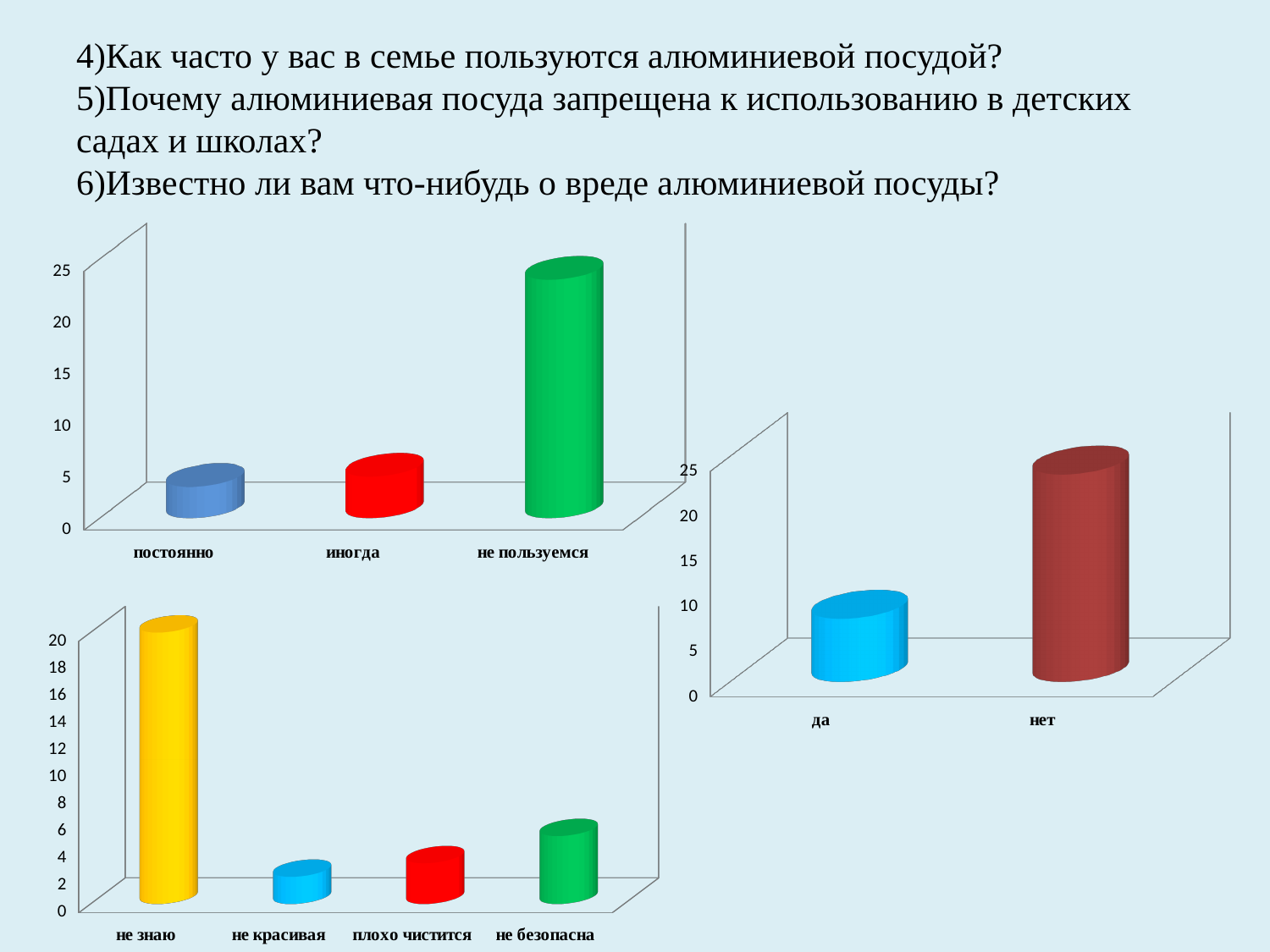
In the right chart, is the value for 'да' greater or less than 10? less In the bottom-left chart, is the value for 'не знаю' greater or less than 15? greater What kind of chart is the right chart (да / нет)? bar chart In the top-left chart, is the value for 'не пользуемся' greater or less than 20? greater How many categories are shown in the top-left chart? 3 In the bottom-left chart (не знаю / не красивая / плохо чистится / не безопасна), which category has the highest value? не знаю How many categories are shown in the bottom-left chart? 4 In the top-left chart (постоянно / иногда / не пользуемся), which category has the highest value? не пользуемся In the right chart (да / нет), which category has the larger value? нет In the bottom-left chart, which category has the lowest value? не красивая